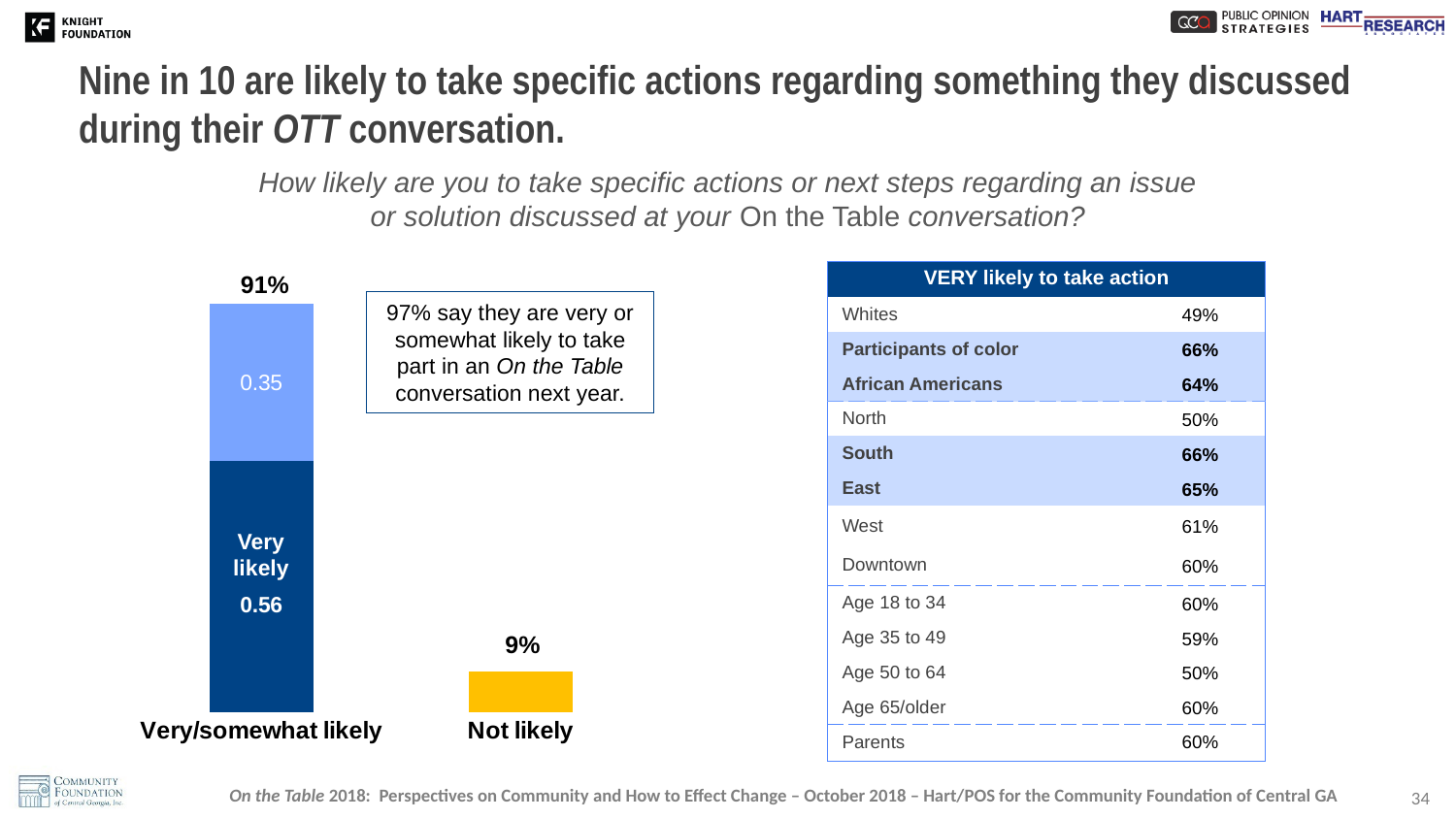
Which category in the bar chart has the lowest value? Not likely What value is printed on the light blue upper segment of the Very/somewhat likely bar? 0.35 Which category has the higher value, Very/somewhat likely or Not likely? Very/somewhat likely Which category in the bar chart has the highest value? Very/somewhat likely How many categories are shown on the x axis of the bar chart? 2 What kind of chart is used to show the likelihood of taking action? Bar chart What percentage is shown above the Very/somewhat likely bar? 91% What percentage is shown for the Not likely bar? 9% What is the difference in percentage points between the Very/somewhat likely bar (91%) and the Not likely bar (9%)? 82 percentage points What label appears inside the dark blue segment of the stacked bar? Very likely What colour is the Not likely bar? Yellow What value is printed on the dark blue 'Very likely' segment of the stacked bar? 0.56